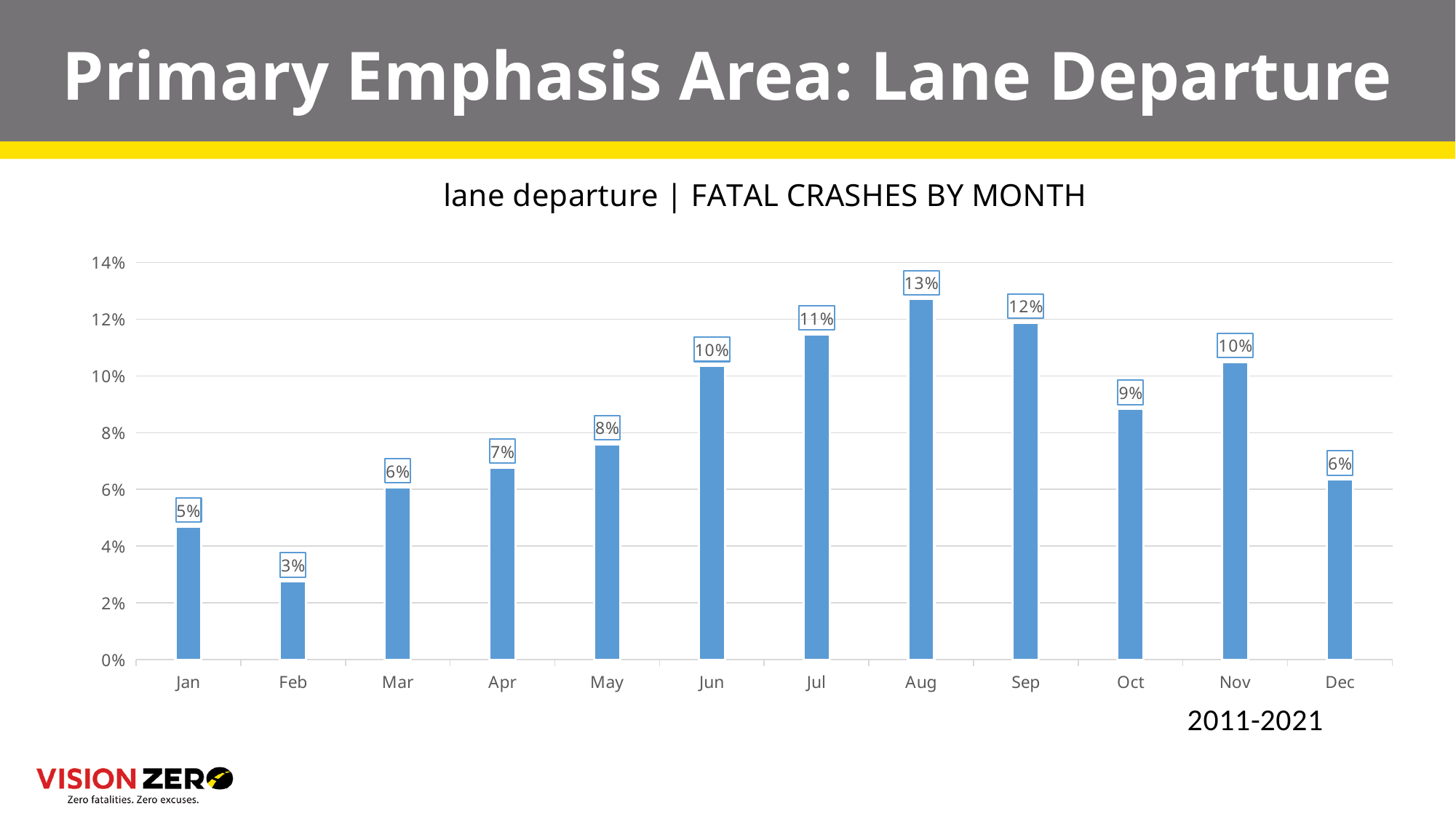
What is the value shown for February? 3% Do the values rise or fall from January to August? Rise Which month has the highest share of fatal crashes? Aug Is the value for September greater or less than 10%? greater Which month has a larger value, July or May? Jul Which month has the lowest share of fatal crashes? Feb By how many percentage points does August exceed February? 10 What kind of chart is shown on the slide? Bar chart What percentage of lane departure fatal crashes occurred in August? 13% By how many percentage points does September exceed April? 5 How many months are shown on the x axis? 12 What percentage is shown for October? 9%